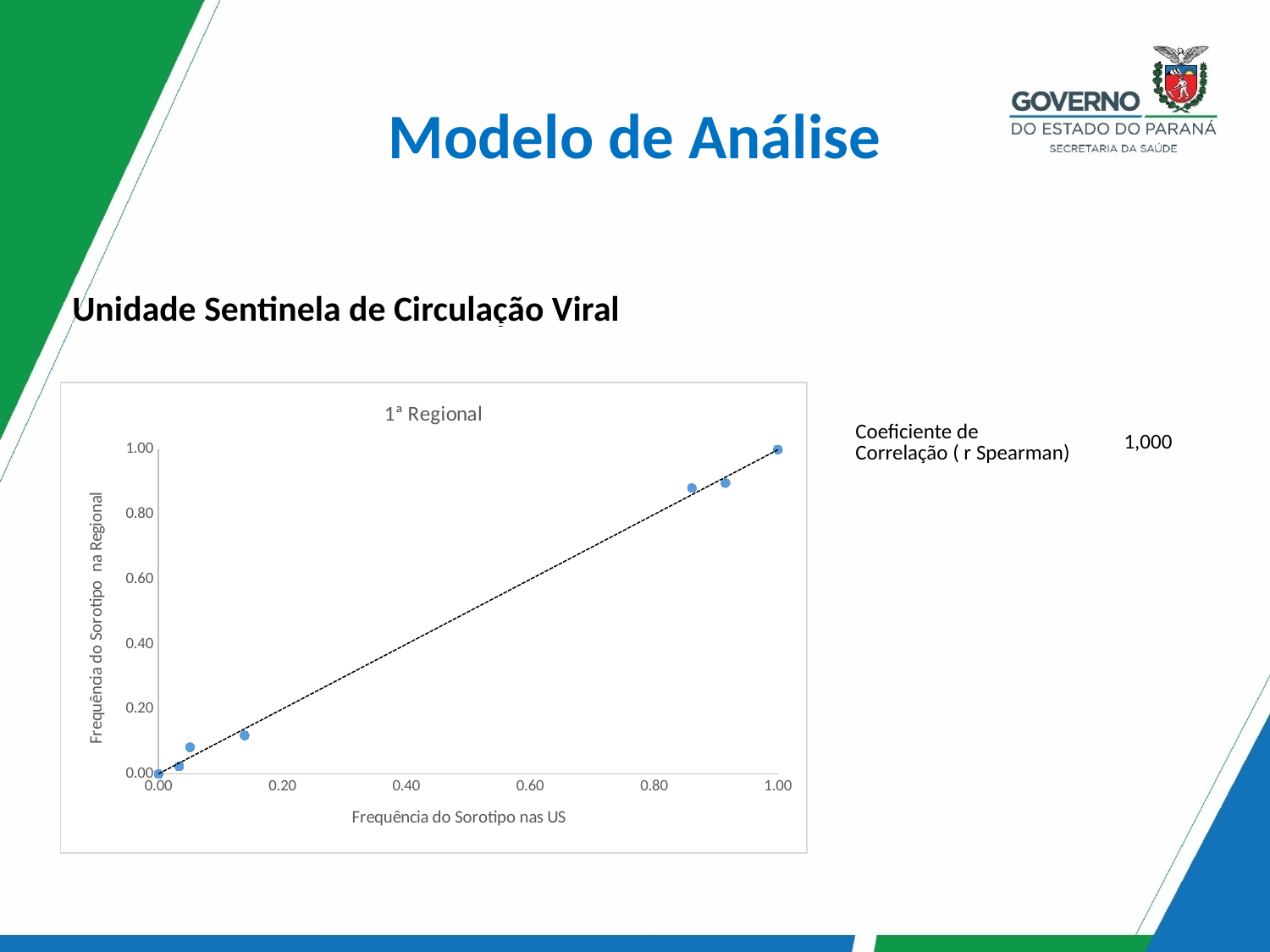
What is the highest tick value shown on the y axis? 1.00 Which has the larger y value: the point near x = 0.86 or the point near x = 0.14? the point near x = 0.86 What is the title of the chart? 1ª Regional Is the y value of the point plotted near x = 0.05 greater or less than 0.20? less What kind of chart is shown on the slide? scatter chart What is the label of the x axis of the chart? Frequência do Sorotipo nas US Do the plotted points rise or fall as the x-axis value increases? rise Is the y value of the point plotted near x = 0.86 greater or less than 0.80? greater Is the y value of the point plotted near x = 0.14 greater or less than 0.20? less What Spearman correlation coefficient is reported next to the chart? 1,000 What is the highest tick value shown on the x axis? 1.00